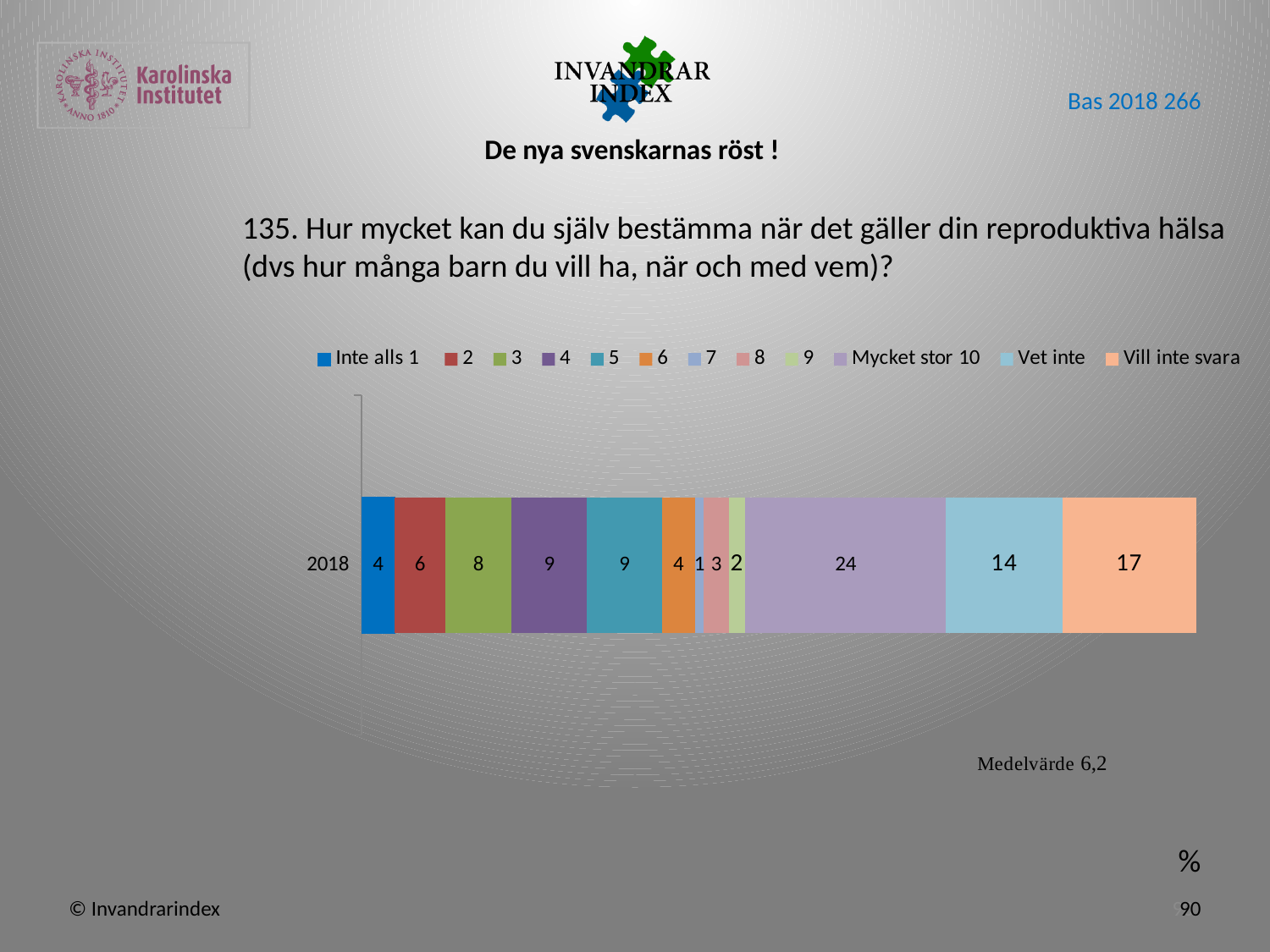
Which series has the largest segment in the 2018 bar? Mycket stor 10 What mean value (Medelvärde) is stated below the chart? 6,2 What is the value for "Vet inte" in the 2018 bar? 14 Which series has the smallest segment in the 2018 bar? 7 What is the difference between the values for "Mycket stor 10" and "Vill inte svara"? 7 Which is larger in the 2018 bar, the value for "3" or the value for "2"? 3 How many series does the legend list? 12 How many categories (years) are plotted on the y axis? 1 What is the value for "Mycket stor 10" in the 2018 bar? 24 What kind of chart is shown on the slide? stacked bar chart What is the value for "Vill inte svara" in the 2018 bar? 17 What is the value for "Inte alls 1" in the 2018 bar? 4